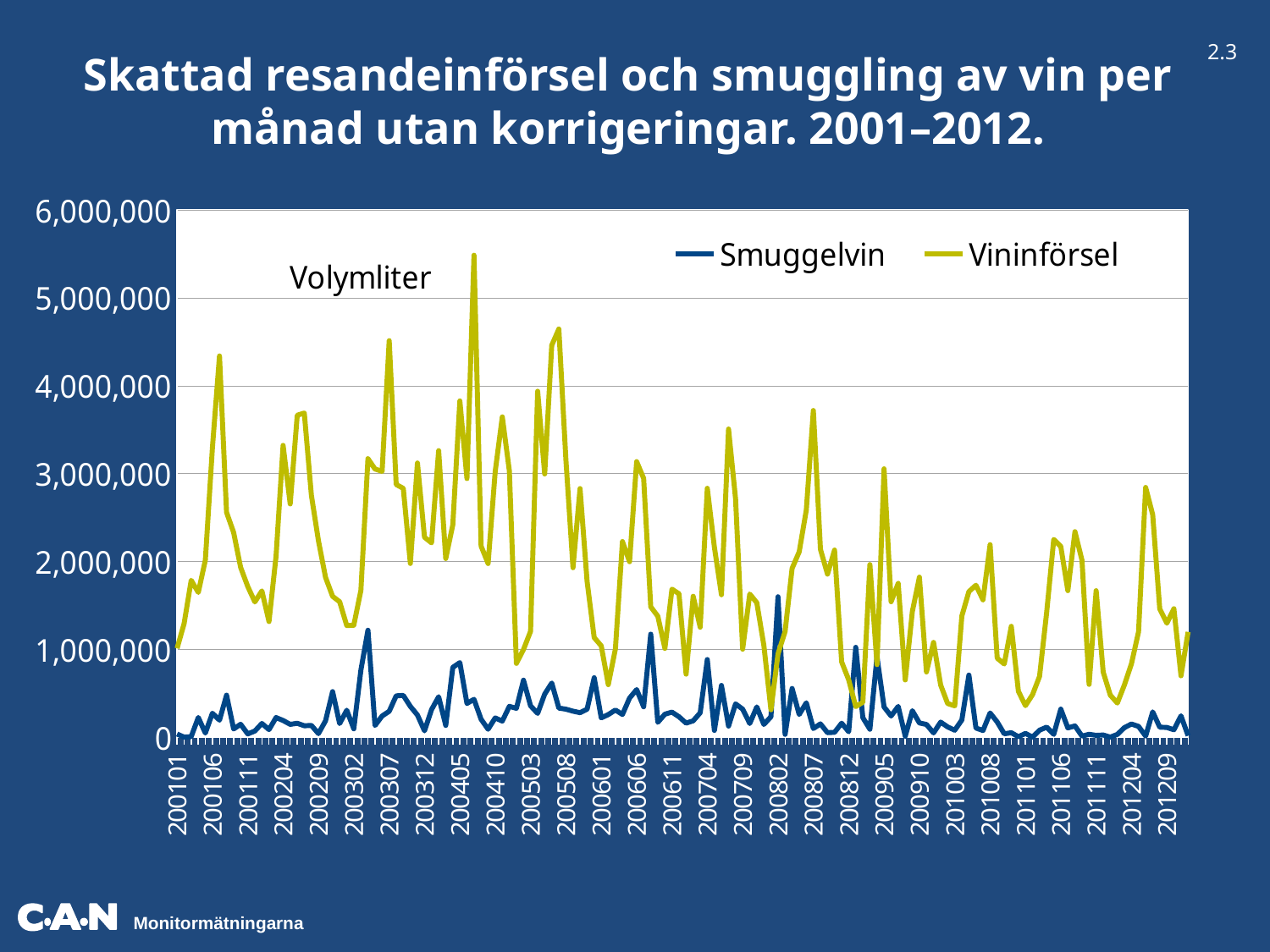
Is the value of Smuggelvin at 200802 greater or less than 1,000,000? greater What kind of chart is shown on the slide? Line chart How many series does the legend list? 2 Is the value of Vininförsel at 200508 greater or less than 4,000,000? less Is the peak value of Vininförsel around 200405 greater or less than 5,000,000? greater What are the two series named in the legend? Smuggelvin and Vininförsel Overall, do the Vininförsel values rise or fall from 2001 to 2012? fall Which series reaches the highest value on the chart? Vininförsel What unit label is shown inside the plot area? Volymliter